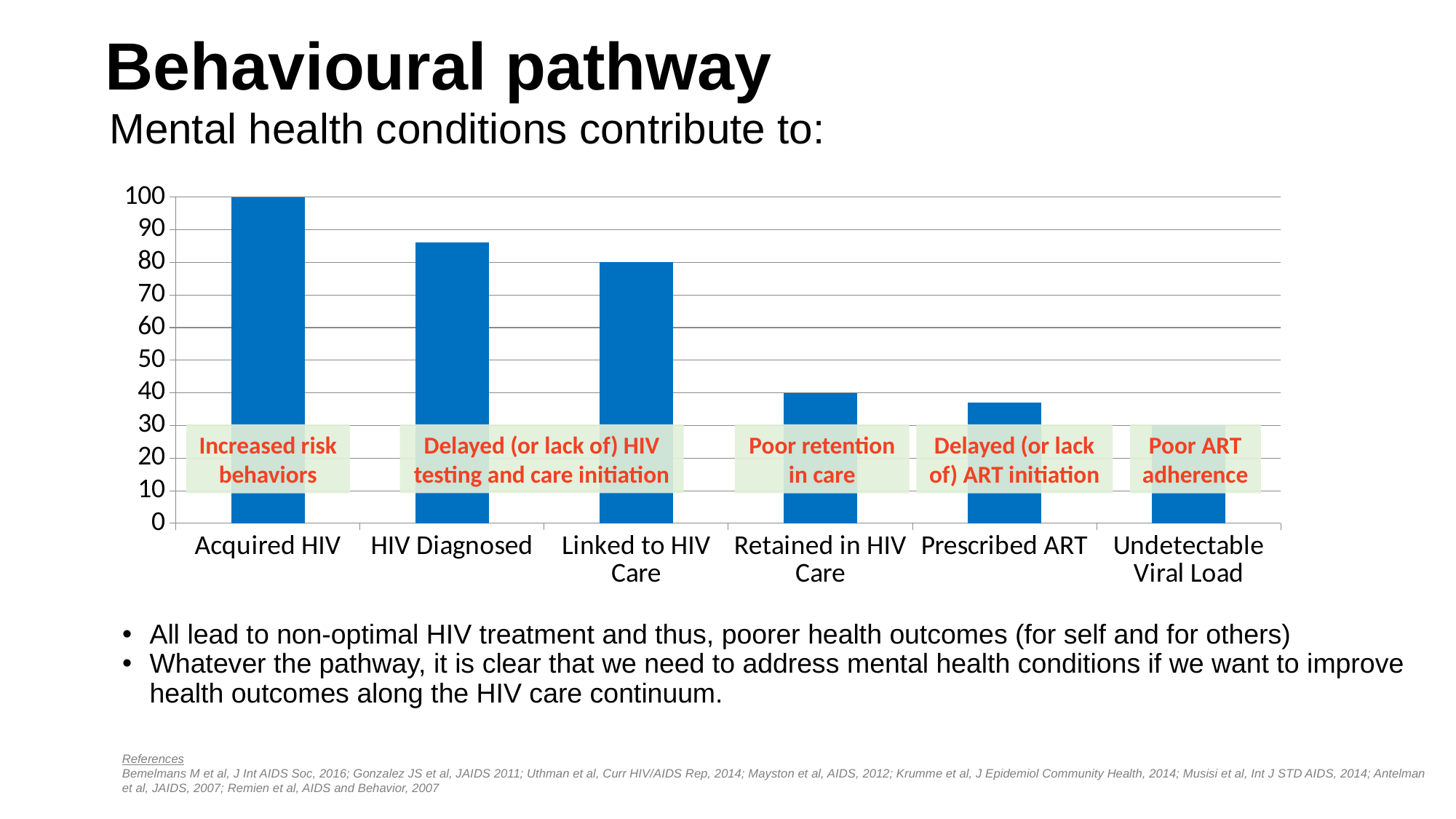
What is the value for Acquired HIV? 100 What is the value for Retained in HIV Care? 40 What kind of chart is shown on the slide? bar chart Which category has the highest bar? Acquired HIV Do the bar values rise or fall from left to right along the x axis? fall Is the value for Prescribed ART greater or less than 40? less How many categories are shown on the x axis? 6 What is the difference between the values for Acquired HIV and Linked to HIV Care? 20 What is the value for Linked to HIV Care? 80 Which category has the lowest bar? Undetectable Viral Load Which is larger, the value for HIV Diagnosed or the value for Linked to HIV Care? HIV Diagnosed Is the value for HIV Diagnosed greater or less than 90? less